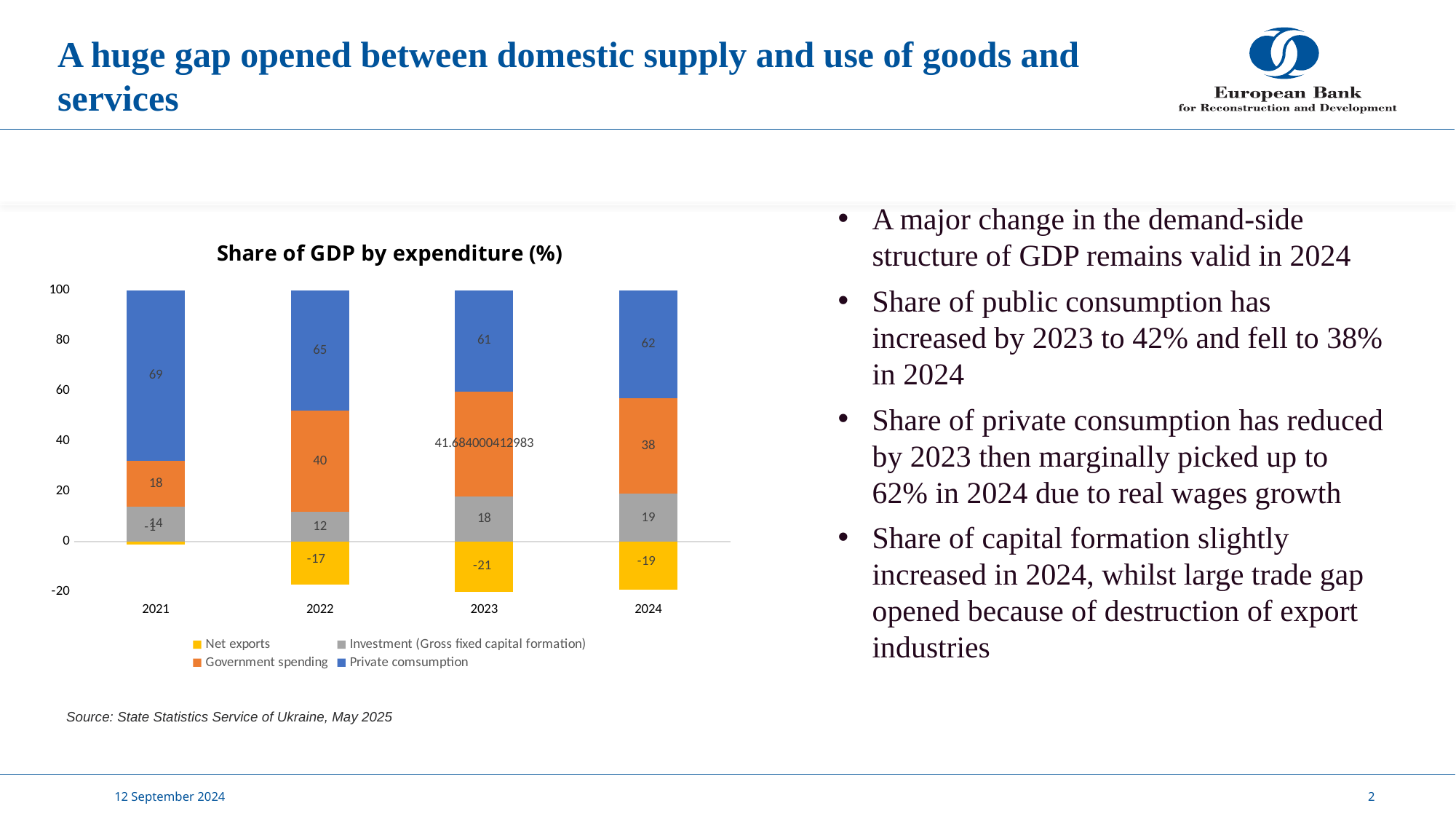
Which year has the larger Investment (Gross fixed capital formation) share, 2022 or 2023? 2023 In which year is the Net exports value lowest? 2023 What is the difference between Government spending in 2022 and in 2024? 2 What is the value for Private consumption in 2021? 69 What kind of chart is shown on the slide? Stacked bar chart How many series does the legend of the chart list? 4 What is the value for Net exports in 2023? -21 What is the value for Investment (Gross fixed capital formation) in 2024? 19 How many years are shown on the x axis of the chart? 4 In which year is the Private consumption share highest? 2021 Does the Private consumption share rise or fall from 2021 to 2023? Fall What is the value for Government spending in 2022? 40